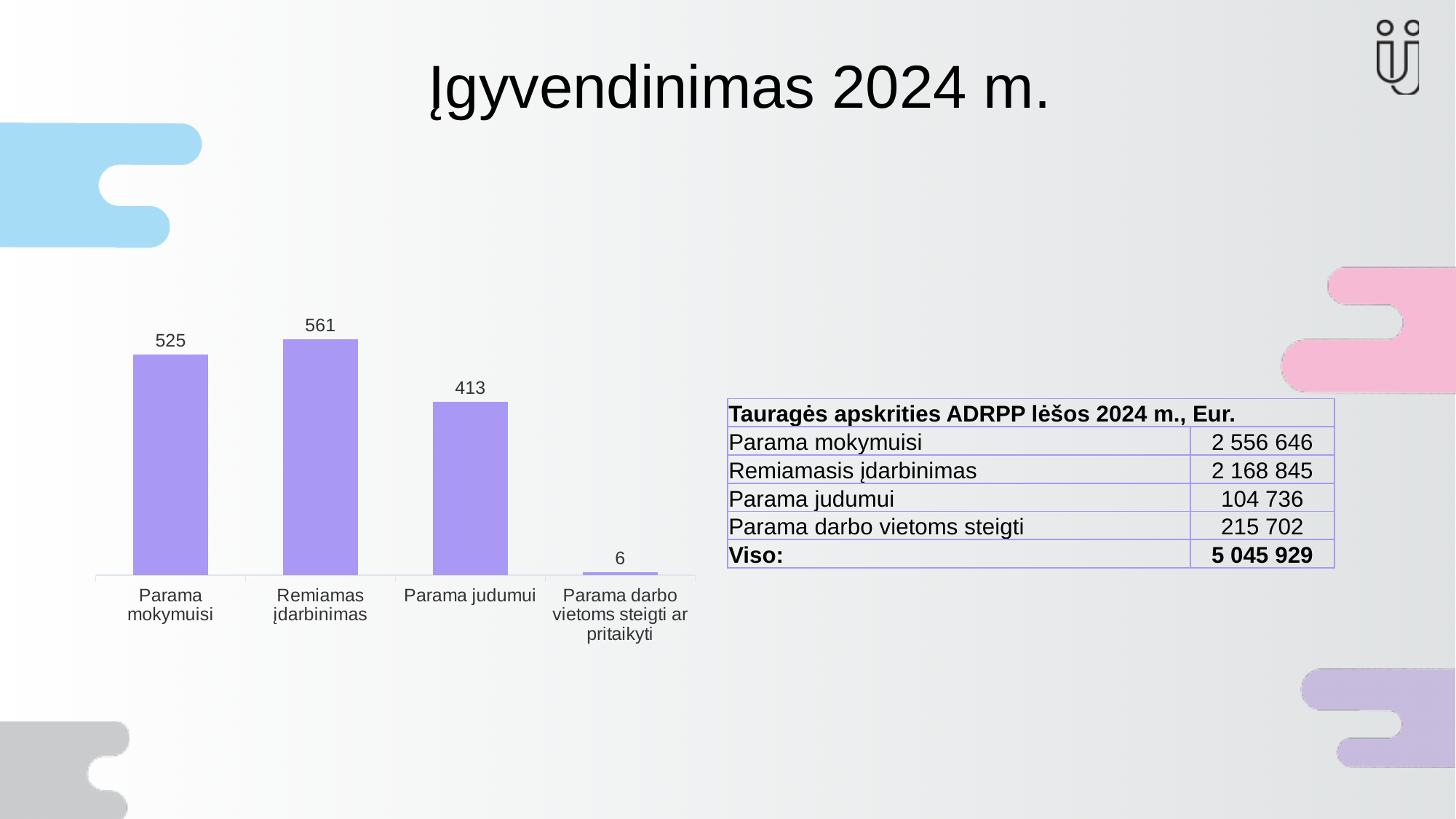
Which is larger in the bar chart: Parama judumui or Parama mokymuisi? Parama mokymuisi What is the difference between the values for Parama mokymuisi and Parama judumui in the bar chart? 112 What is the value for Remiamas įdarbinimas in the bar chart? 561 What colour are the bars in the chart? purple What is the difference between the values for Remiamas įdarbinimas and Parama mokymuisi in the bar chart? 36 Which category has the highest value in the bar chart? Remiamas įdarbinimas What kind of chart is shown on the slide? bar chart How many categories are shown in the bar chart? 4 What is the value for Parama darbo vietoms steigti ar pritaikyti in the bar chart? 6 What is the value for Parama judumui in the bar chart? 413 Which category has the lowest value in the bar chart? Parama darbo vietoms steigti ar pritaikyti What is the value for Parama mokymuisi in the bar chart? 525